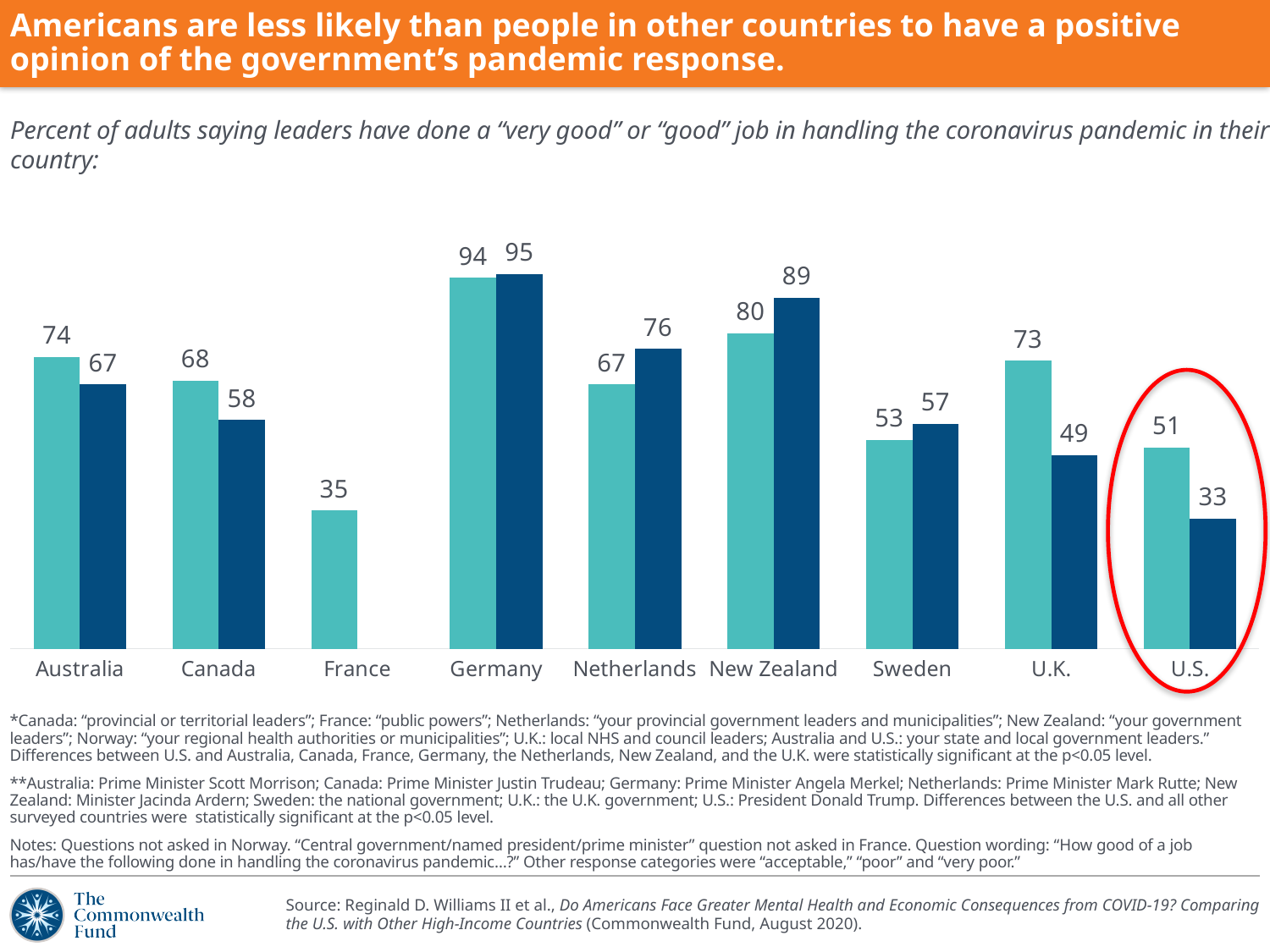
What is the value of the light teal bar for Australia? 74 Which country has the lowest light teal bar? France For the Netherlands, which is larger: the light teal bar or the dark blue bar? the dark blue bar How many countries are shown on the x axis? 9 What type of chart is shown on the slide? bar chart Which country has the highest dark blue bar? Germany What is the value of the dark blue bar for New Zealand? 89 What is the difference between the light teal bars for Germany and the U.S.? 43 What is the difference between the light teal and dark blue bars for the U.K.? 24 Which country has the lowest dark blue bar? U.S. What is the value of the dark blue bar for the U.S.? 33 What is the value shown for France? 35